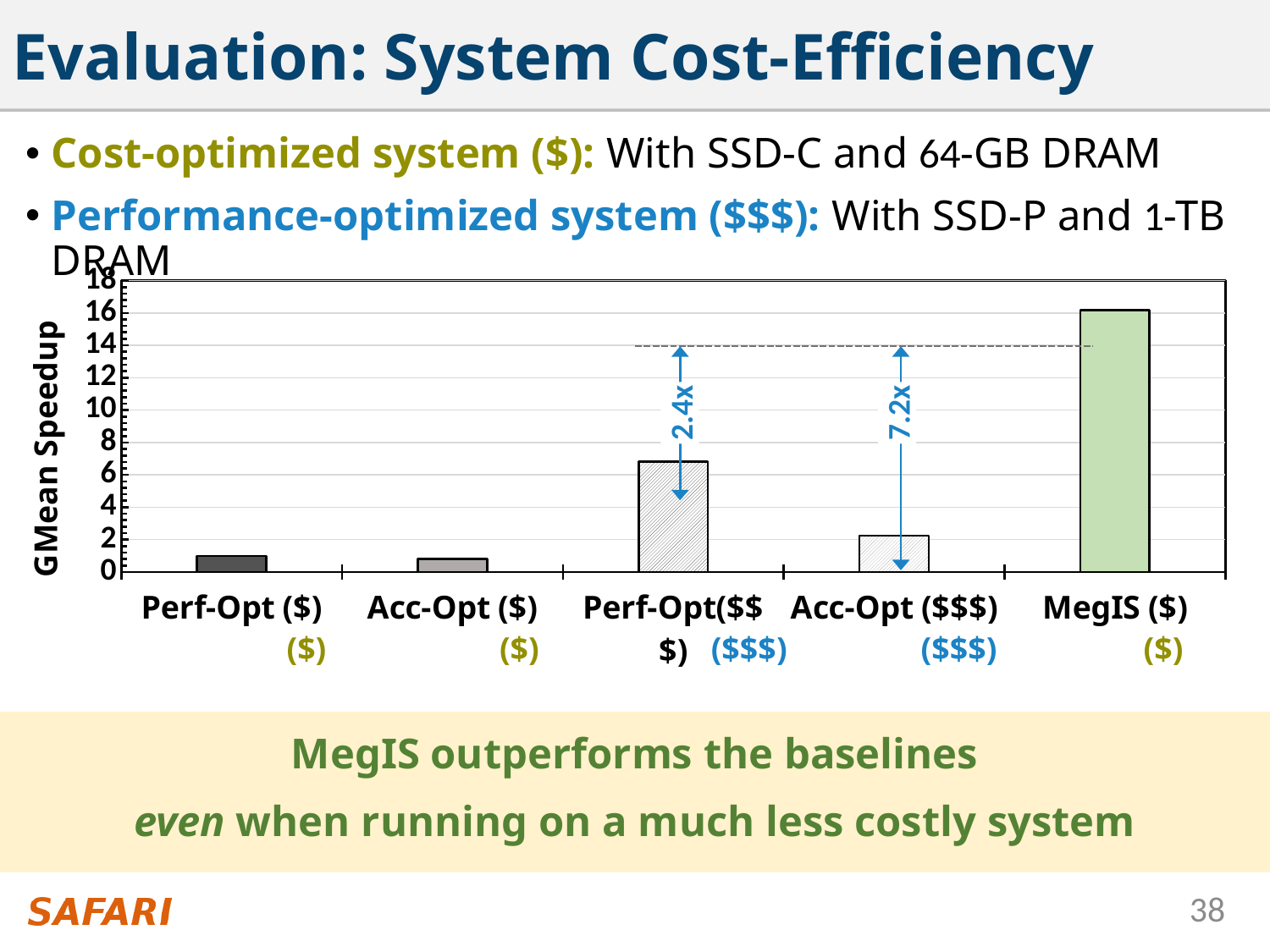
Which has a higher GMean Speedup, MegIS ($) or Perf-Opt ($$$)? MegIS ($) What speedup factor is annotated between the Perf-Opt ($$$) bar and the MegIS level? 2.4x Is the GMean Speedup for Perf-Opt ($$$) greater or less than 8? less What speedup factor is annotated between the Acc-Opt ($$$) bar and the MegIS level? 7.2x Is the GMean Speedup for Perf-Opt ($) greater or less than 2? less Which category has the highest GMean Speedup? MegIS ($) Which has a higher GMean Speedup, Perf-Opt ($$$) or Acc-Opt ($$$)? Perf-Opt ($$$) What is the label of the y axis of the chart? GMean Speedup What type of chart is shown on the slide? bar chart How many categories are shown on the x axis of the chart? 5